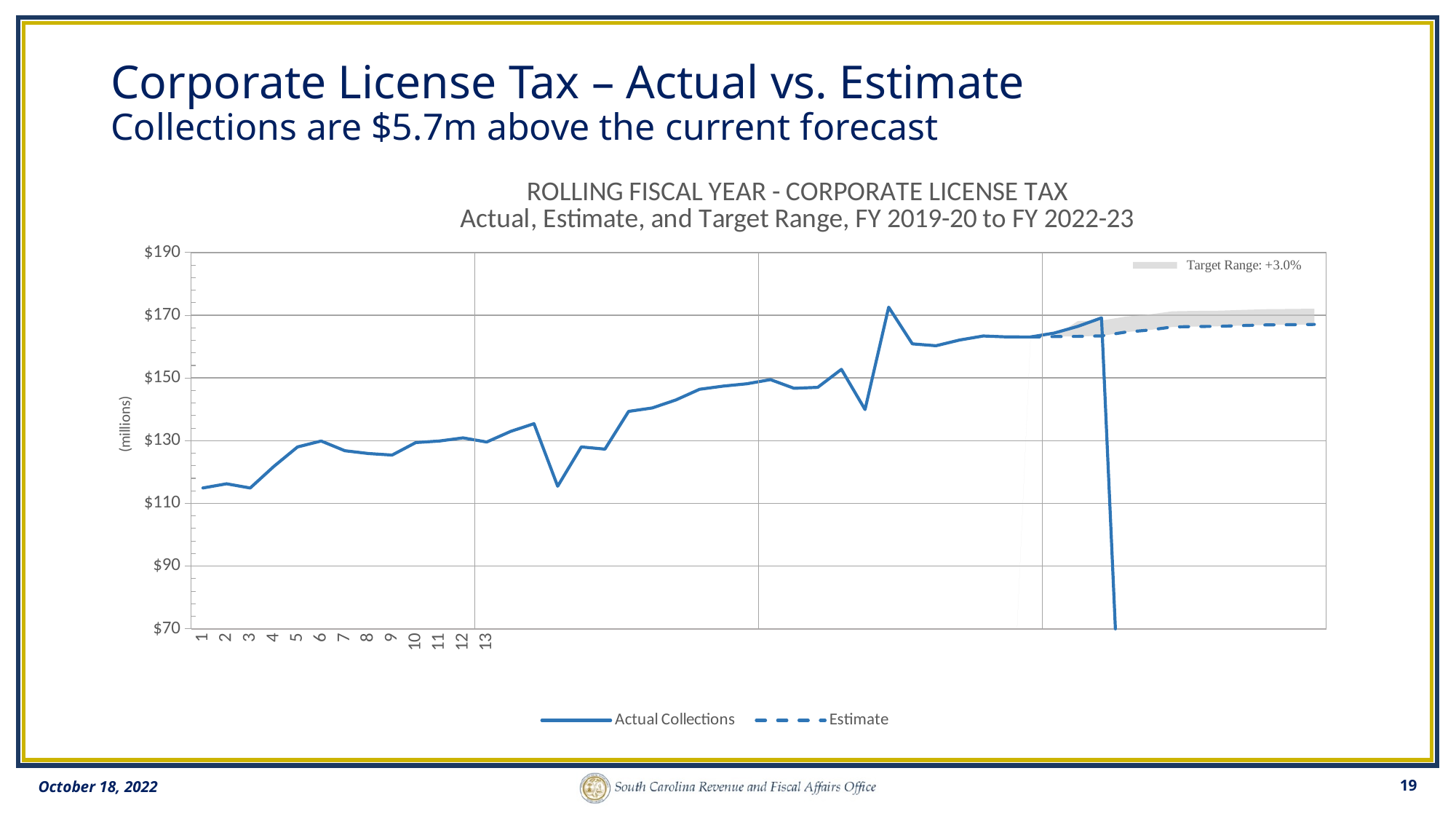
What is the title of the chart? ROLLING FISCAL YEAR - CORPORATE LICENSE TAX Actual, Estimate, and Target Range, FY 2019-20 to FY 2022-23 Which is larger, the Actual Collections value at point 4 or at point 5? point 5 What are the two series named in the legend at the bottom of the chart? Actual Collections and Estimate What is the highest value shown on the y axis? $190 Is the Actual Collections value at point 4 greater or less than $130? less Do the Actual Collections values generally rise or fall from point 1 to point 13? rise What kind of chart is shown on the slide? line chart Is the Actual Collections value at point 9 greater or less than $130? less How many series does the legend at the bottom of the chart list? 2 Is the Actual Collections value at point 1 greater or less than $130? less Which is larger, the Actual Collections value at point 1 or at point 13? point 13